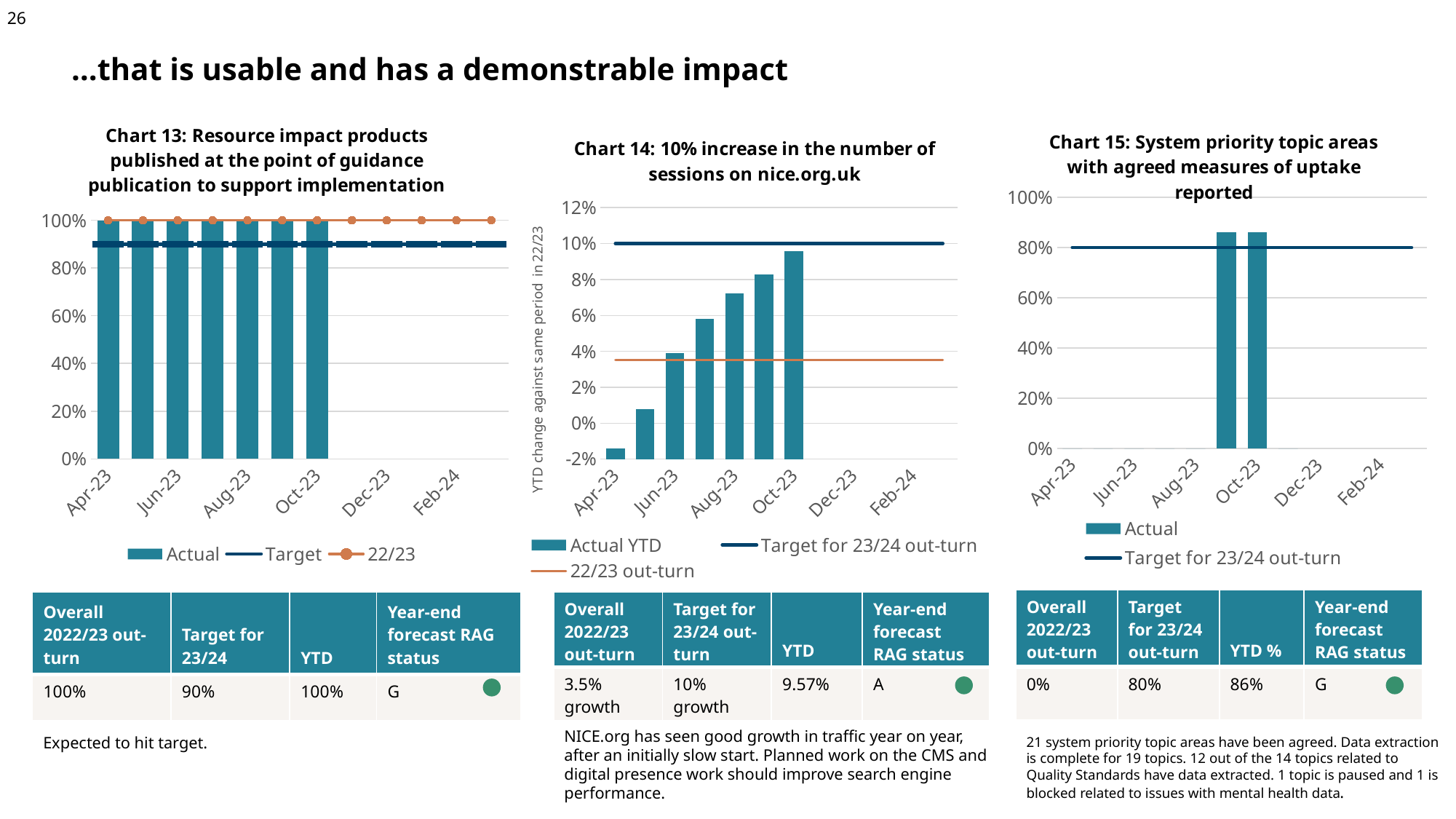
In Chart 13, what is the Actual value for Apr-23? 100% In Chart 14, which month has the lowest Actual YTD bar? Apr-23 How many bars are plotted in Chart 15: System priority topic areas with agreed measures of uptake reported? 2 In Chart 14, which is larger, the Actual YTD bar for Jun-23 or for Aug-23? Aug-23 What kind of chart is Chart 13: Resource impact products published at the point of guidance publication to support implementation? combination bar and line chart In Chart 14: 10% increase in the number of sessions on nice.org.uk, do the Actual YTD bars rise or fall from Apr-23 to Oct-23? rise In Chart 14, which month has the highest Actual YTD bar? Oct-23 In Chart 14, is the Actual YTD value for Oct-23 greater or less than 10%? less In Chart 15, is the Actual value for Oct-23 greater or less than 80%? greater How many series does the legend of Chart 13 list? 3 How many bars are plotted in Chart 13? 7 In Chart 14, is the Actual YTD value for Apr-23 greater or less than 0%? less